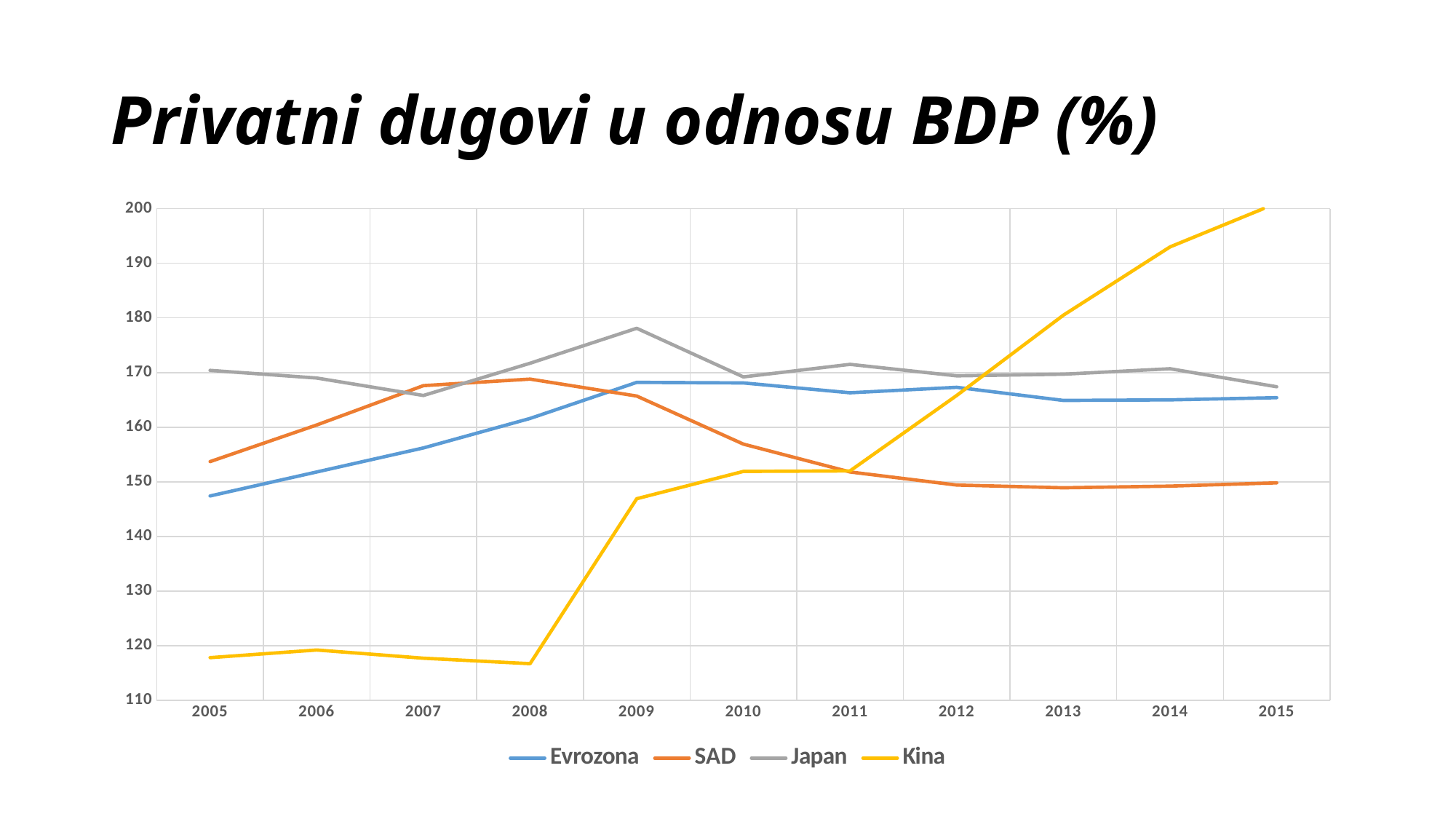
Does the Kina line rise or fall from 2008 to 2015? rise Is the value for Japan in 2009 greater or less than 170? greater How many series does the legend list? 4 Which series has the lowest value in 2005? Kina Is the value for Kina in 2008 greater or less than 120? less Is the value for SAD in 2005 greater or less than 150? greater Which series has the highest value in 2015? Kina What is the title of the chart? Privatni dugovi u odnosu BDP (%) In 2009, which is larger: Japan or SAD? Japan How many years are shown on the x axis? 11 What kind of chart is shown on the slide? line chart